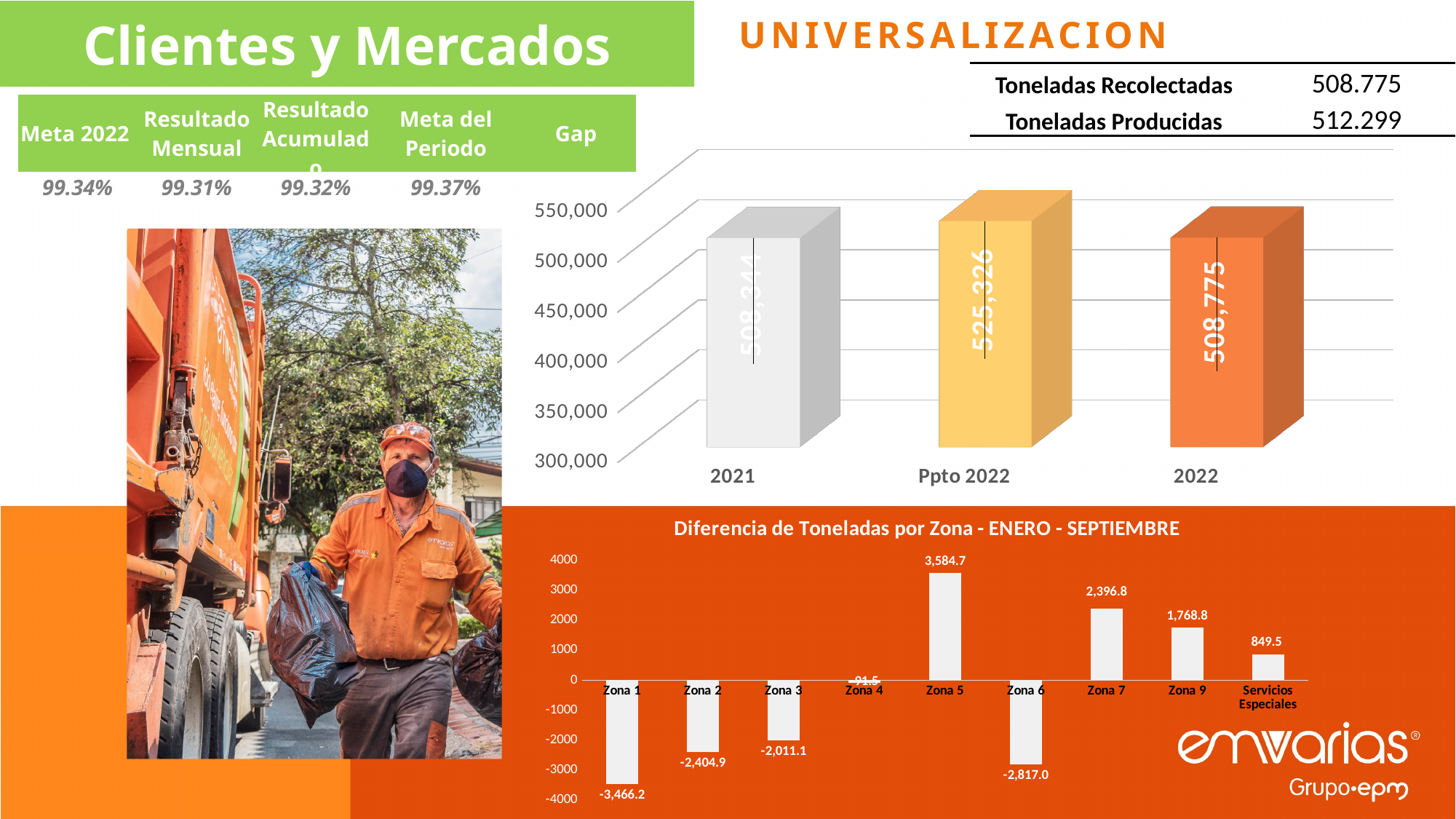
In the chart 'Diferencia de Toneladas por Zona - ENERO - SEPTIEMBRE', what is the value for Servicios Especiales? 849.5 In the top bar chart, how many categories are shown? 3 In the chart 'Diferencia de Toneladas por Zona - ENERO - SEPTIEMBRE', what is the value for Zona 5? 3,584.7 In the chart 'Diferencia de Toneladas por Zona - ENERO - SEPTIEMBRE', which category has the lowest value? Zona 1 In the chart 'Diferencia de Toneladas por Zona - ENERO - SEPTIEMBRE', which is larger, the value for Zona 7 or Zona 9? Zona 7 In the top bar chart, what is the value for 2022? 508,775 In the top bar chart, what is the value for Ppto 2022? 525,326 In the chart 'Diferencia de Toneladas por Zona - ENERO - SEPTIEMBRE', how many categories are shown? 9 In the top bar chart, is the value for 2021 greater or less than 500,000? greater In the top bar chart, which category has the highest value? Ppto 2022 In the chart 'Diferencia de Toneladas por Zona - ENERO - SEPTIEMBRE', what is the value for Zona 1? -3,466.2 In the chart 'Diferencia de Toneladas por Zona - ENERO - SEPTIEMBRE', which category has the highest value? Zona 5